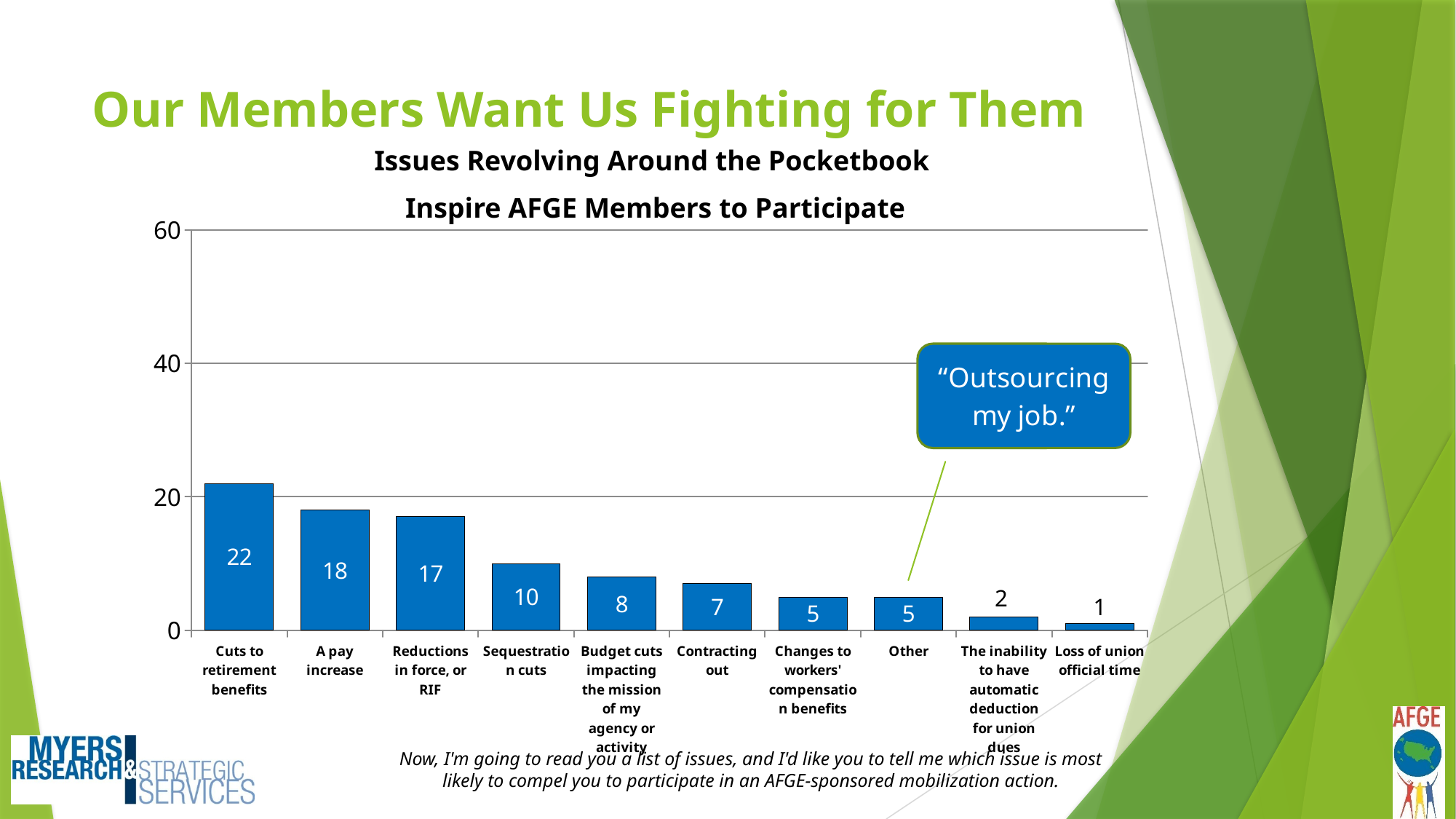
What does the callout box pointing to the Other bar say? "Outsourcing my job." What is the value for Loss of union official time? 1 How many categories are shown on the chart? 10 Is the value for A pay increase greater or less than 20? less Which is larger, the value for Reductions in force, or RIF or the value for Sequestration cuts? Reductions in force, or RIF What is the value for Cuts to retirement benefits? 22 What kind of chart is shown on the slide? bar chart What is the value for Contracting out? 7 What is the value for Sequestration cuts? 10 Which category has the highest value? Cuts to retirement benefits Which category has the lowest value? Loss of union official time What is the difference between the values for Cuts to retirement benefits and A pay increase? 4